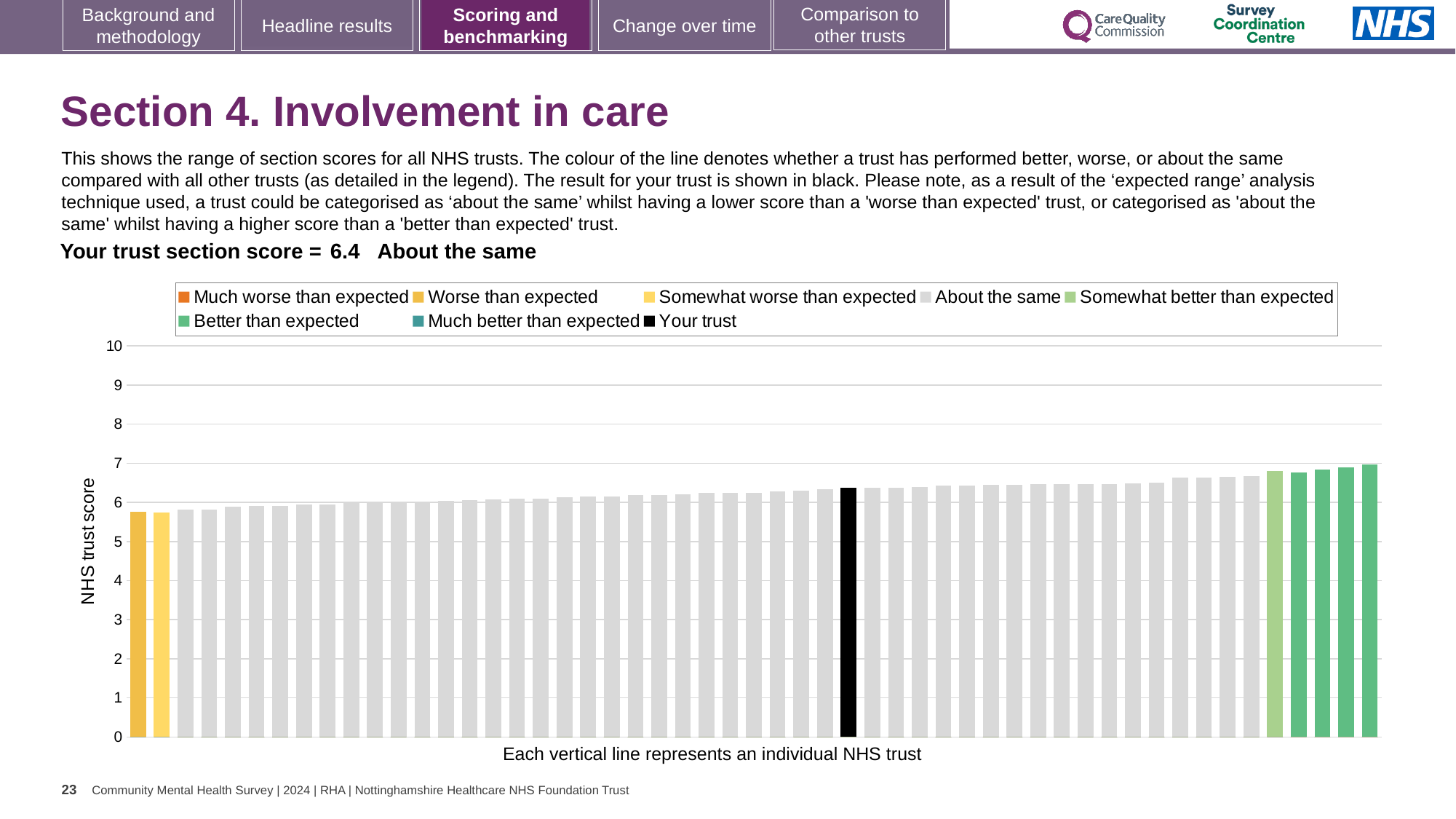
How many bars are coloured light green (Somewhat better than expected)? 1 How many bars are coloured dark green (Better than expected)? 4 Is the value of the leftmost bar greater or less than 6? less What is the label on the vertical axis of the chart? NHS trust score Is the value of the leftmost bar greater or less than 5? greater How many entries does the chart legend list? 8 What is the section score for your trust shown on the slide? 6.4 What colour is the bar representing your trust? black What kind of chart is shown on the slide? bar chart How many bars are coloured yellow (Worse than expected)? 1 Is the value of the black 'Your trust' bar greater or less than 6? greater Do the bar values rise or fall from left to right along the x axis? rise